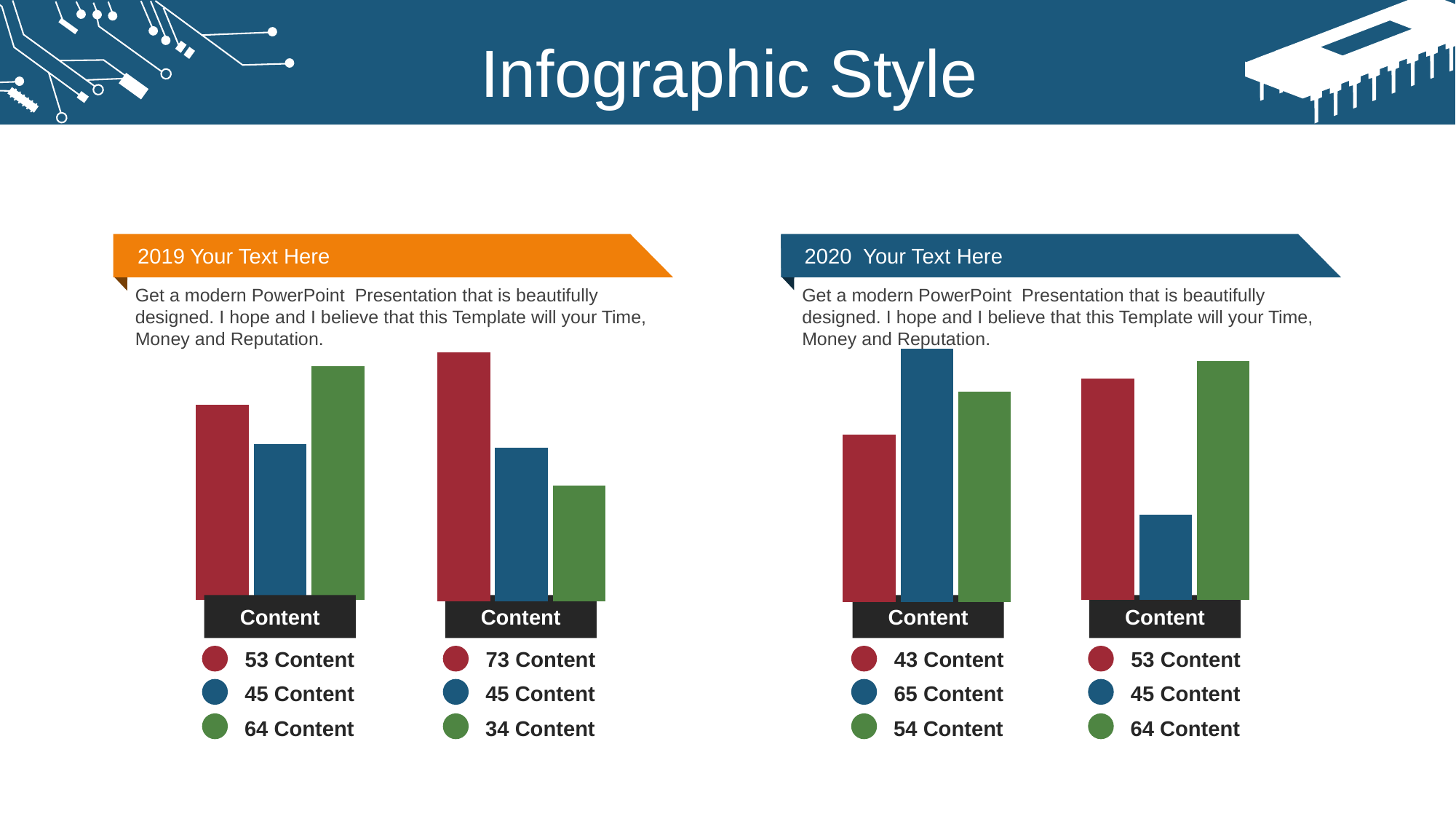
In the 2019 chart, which colour bar is the tallest in the right group? red What type of chart is shown under the 2019 heading? bar chart In the 2019 chart, what is the value of the green bar in the right group? 34 In the 2020 chart, what is the value of the red bar in the left group? 43 How many coloured series are listed below each group in the 2019 chart? 3 In the 2020 chart, what is the value of the blue bar in the left group? 65 In the 2019 chart, what is the difference between the red bar (73) and the green bar (34) in the right group? 39 In the 2020 chart, what is the difference between the green bar (64) and the blue bar (45) in the right group? 19 In the 2019 chart, which is larger in the left group: the red bar or the green bar? green How many bars are plotted in the 2020 chart? 6 In the 2019 chart, what is the value of the red bar in the left group? 53 In the 2020 chart, which colour bar is the lowest in the right group? blue